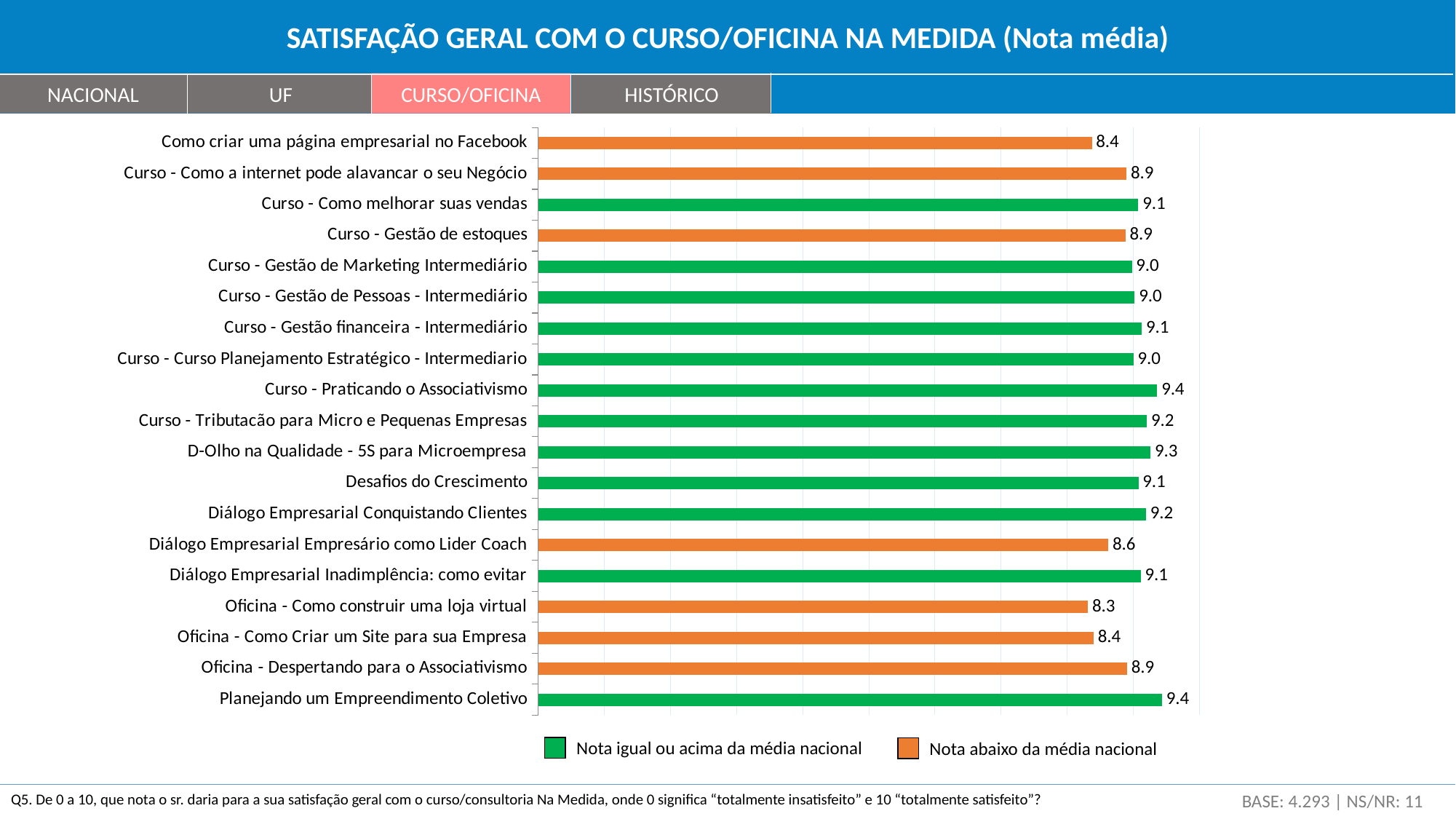
What kind of chart is shown on the slide? Bar chart How many categories are shown in the chart? 19 What is the title of the chart? SATISFAÇÃO GERAL COM O CURSO/OFICINA NA MEDIDA (Nota média) What is the difference between the values for Planejando um Empreendimento Coletivo and Como criar uma página empresarial no Facebook? 1.0 What does the orange colour represent according to the legend? Nota abaixo da média nacional What is the value for Diálogo Empresarial Empresário como Lider Coach? 8.6 Which category has the lowest value? Oficina - Como construir uma loja virtual What is the value for D-Olho na Qualidade - 5S para Microempresa? 9.3 Which is larger, the value for Curso - Tributação para Micro e Pequenas Empresas or the value for Curso - Gestão de estoques? Curso - Tributação para Micro e Pequenas Empresas What is the value for Oficina - Como construir uma loja virtual? 8.3 How many entries does the legend list? 2 What is the value for Curso - Praticando o Associativismo? 9.4